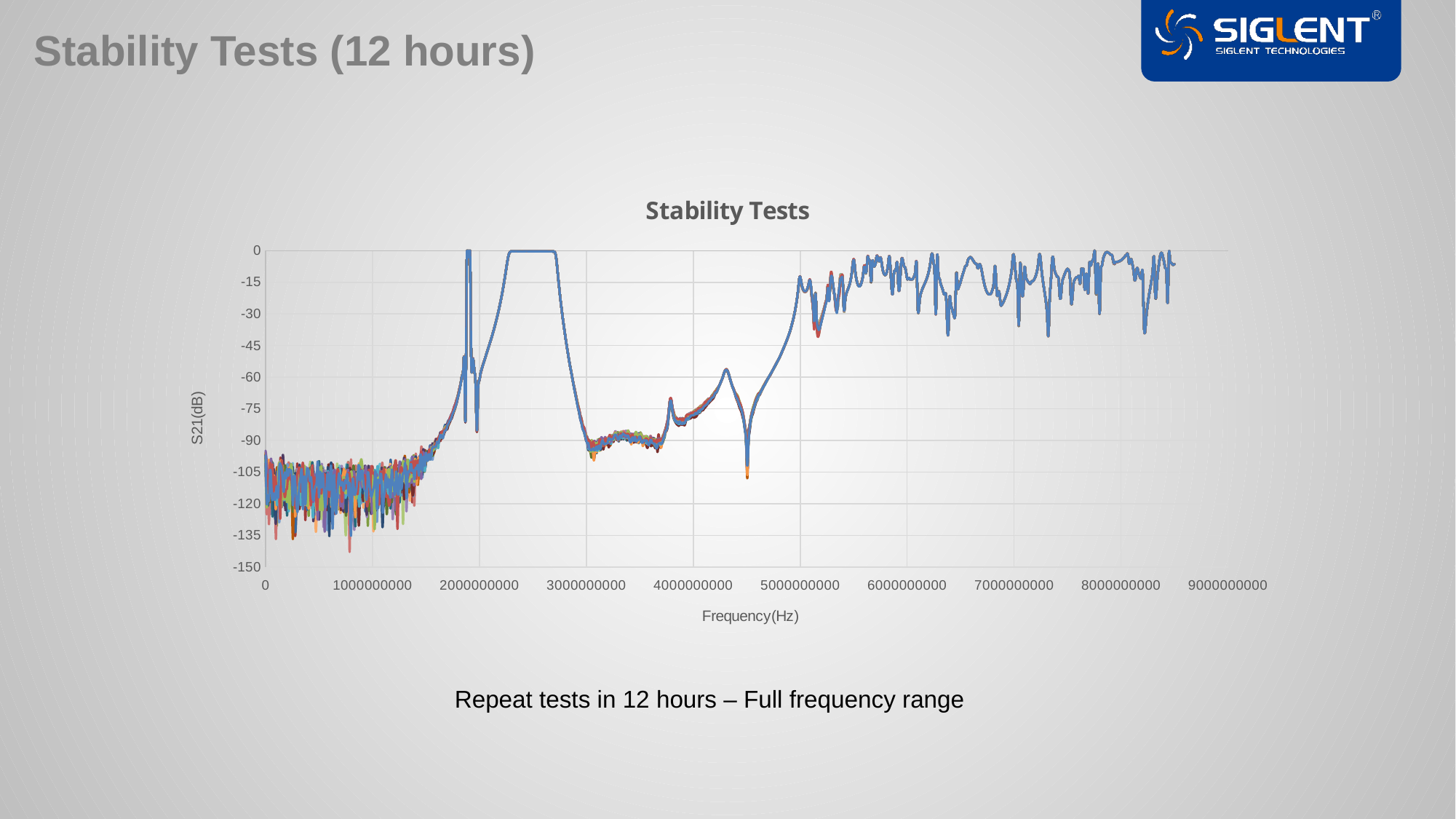
Between 1000000000 Hz and 2000000000 Hz, do the S21 values generally rise or fall as frequency increases? rise Is the value of S21 at a frequency of 4500000000 Hz greater or less than -75? less What is the title of the chart? Stability Tests Is the value of S21 at a frequency of 1000000000 Hz greater or less than -90? less Is the value of S21 at a frequency of 2500000000 Hz greater or less than -15? greater Between 2700000000 Hz and 3000000000 Hz, do the S21 values rise or fall as frequency increases? fall What is the lowest value shown on the y axis of the chart? -150 What is the label of the y axis of the chart? S21(dB) What kind of chart is shown on the slide? line chart